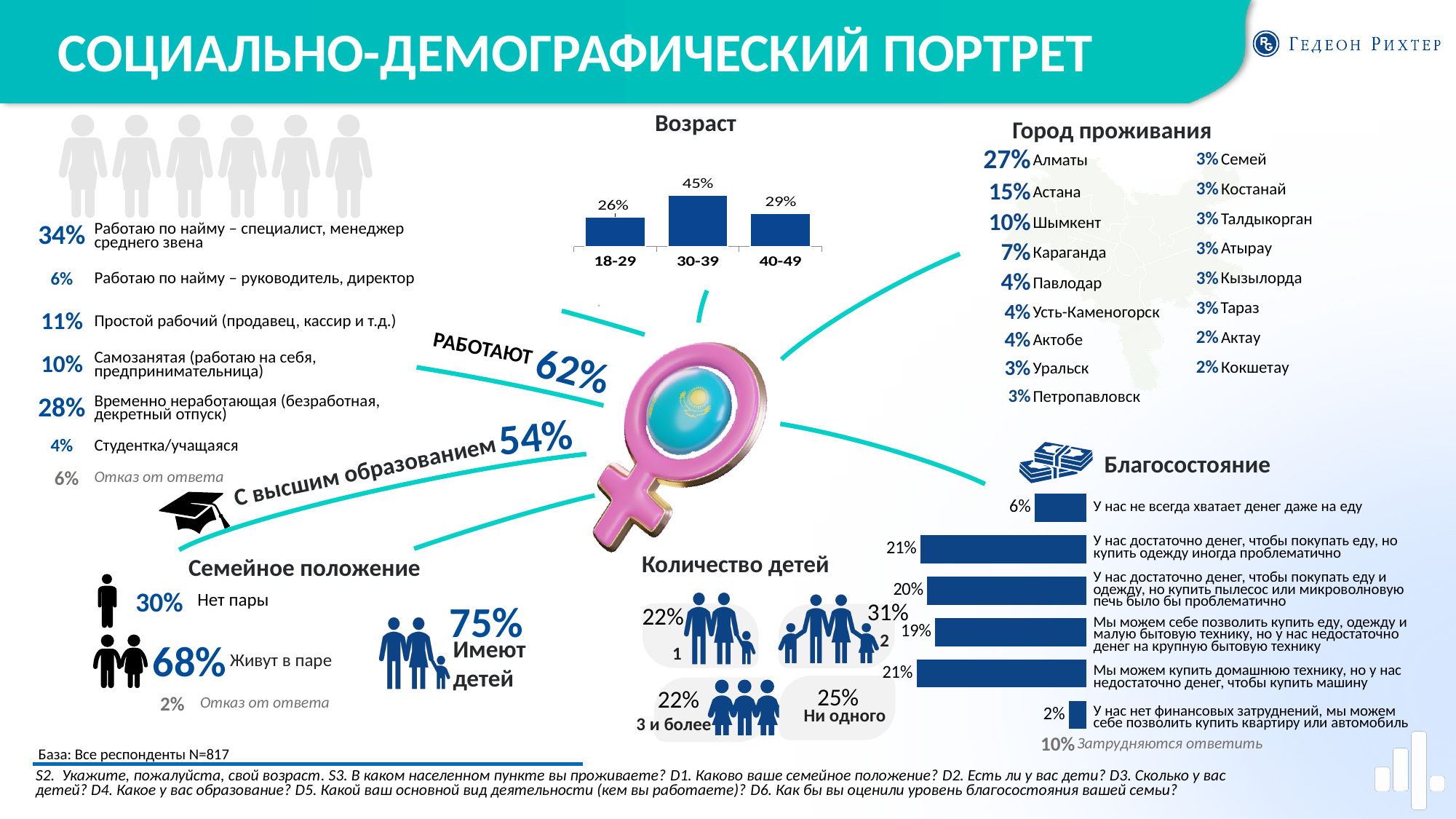
In the 'Возраст' chart, what is the value for the 18-29 age group? 26% In the 'Благосостояние' chart, what is the value for 'У нас нет финансовых затруднений, мы можем себе позволить купить квартиру или автомобиль'? 2% In the 'Возраст' chart, what is the value for the 30-39 age group? 45% In the 'Возраст' chart, what is the difference between the 30-39 and 40-49 age groups? 16% In the 'Возраст' chart, which age group has the highest value? 30-39 How many bars are shown in the 'Благосостояние' chart? 6 In the 'Возраст' chart, which is larger: the value for 40-49 or for 18-29? 40-49 In the 'Благосостояние' chart, what is the value for 'У нас не всегда хватает денег даже на еду'? 6% How many age groups are shown in the 'Возраст' chart? 3 In the 'Возраст' chart, which age group has the lowest value? 18-29 In the 'Благосостояние' chart, which category has the lowest value? У нас нет финансовых затруднений, мы можем себе позволить купить квартиру или автомобиль What kind of chart is the 'Возраст' chart? bar chart